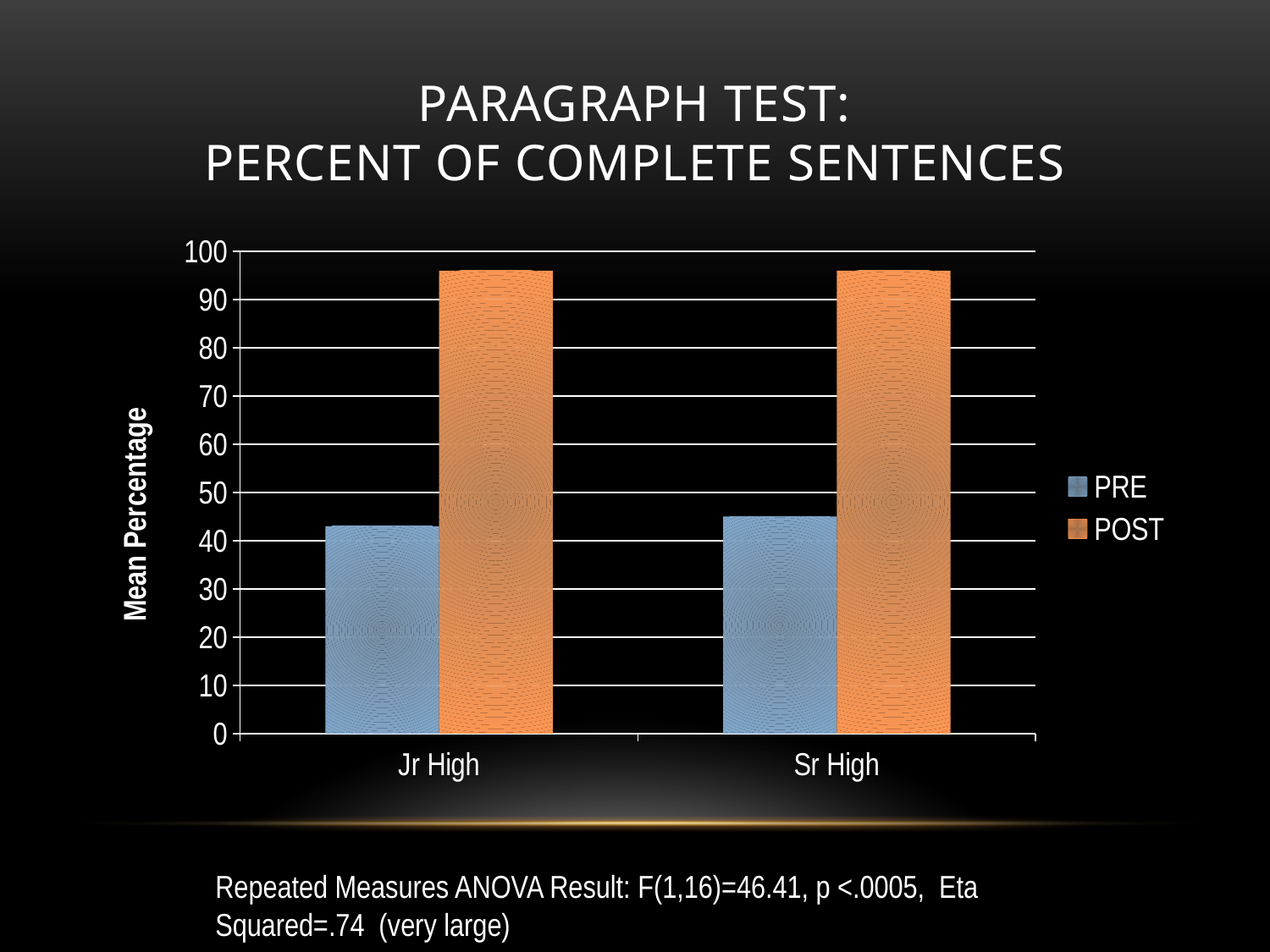
Is the POST value for Jr High greater or less than 90? greater What kind of chart is shown on the slide? bar chart Which series is shown in orange? POST Is the PRE value for Sr High greater or less than 40? greater Is the PRE value for Jr High greater or less than 50? less For Sr High, which is larger, the PRE value or the POST value? POST For Jr High, which is larger, the PRE value or the POST value? POST What is the label on the vertical axis? Mean Percentage How many categories are shown on the x axis? 2 How many series does the legend list? 2